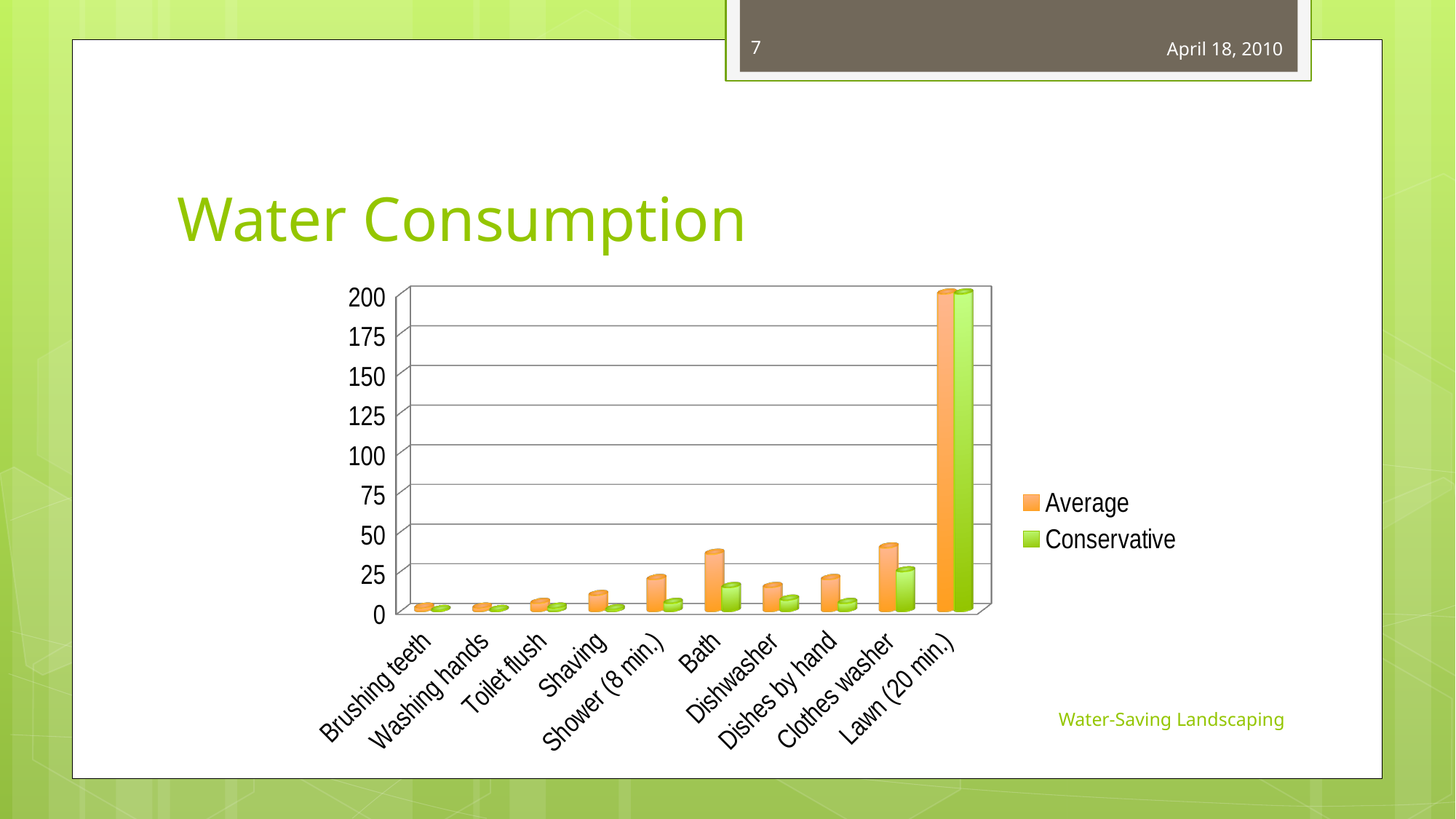
Is the Average value for Shower (8 min.) greater or less than 25? less What colour represents the Average series in the legend? orange What kind of chart is shown on the slide? bar chart Is the Conservative value for Bath greater or less than 25? less Which has the larger Average value, Bath or Dishwasher? Bath For Shower (8 min.), which series has the larger value, Average or Conservative? Average Is the Average value for Clothes washer greater or less than 25? greater Which category has the highest Average value? Lawn (20 min.) What is the title of the chart? Water Consumption How many categories are shown on the x axis? 10 How many series does the legend list? 2